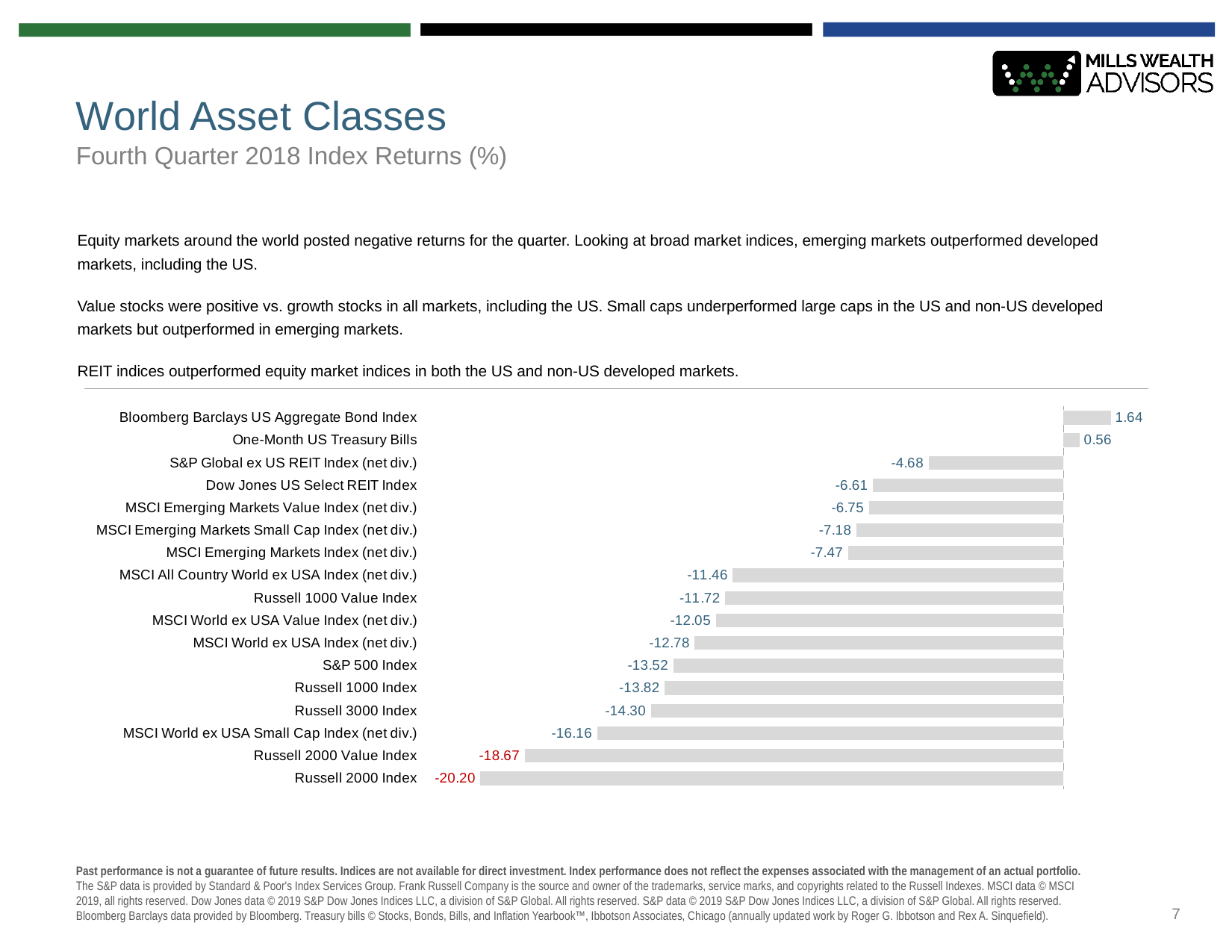
Which is larger, the value for the Dow Jones US Select REIT Index or the MSCI Emerging Markets Value Index (net div.)? Dow Jones US Select REIT Index What is the difference between the Russell 1000 Value Index and the Russell 1000 Index? 2.10 What is the value for the S&P 500 Index? -13.52 How many indices on the chart have a positive value? 2 What is the difference between the S&P 500 Index value and the Russell 2000 Index value? 6.68 Which index has the lowest value on the chart? Russell 2000 Index How many indices are shown on the chart? 17 What is the value for the MSCI Emerging Markets Index (net div.)? -7.47 What is the value for the Russell 2000 Value Index? -18.67 What kind of chart is shown on the slide? Bar chart What is the value for One-Month US Treasury Bills? 0.56 Which index has the highest value on the chart? Bloomberg Barclays US Aggregate Bond Index